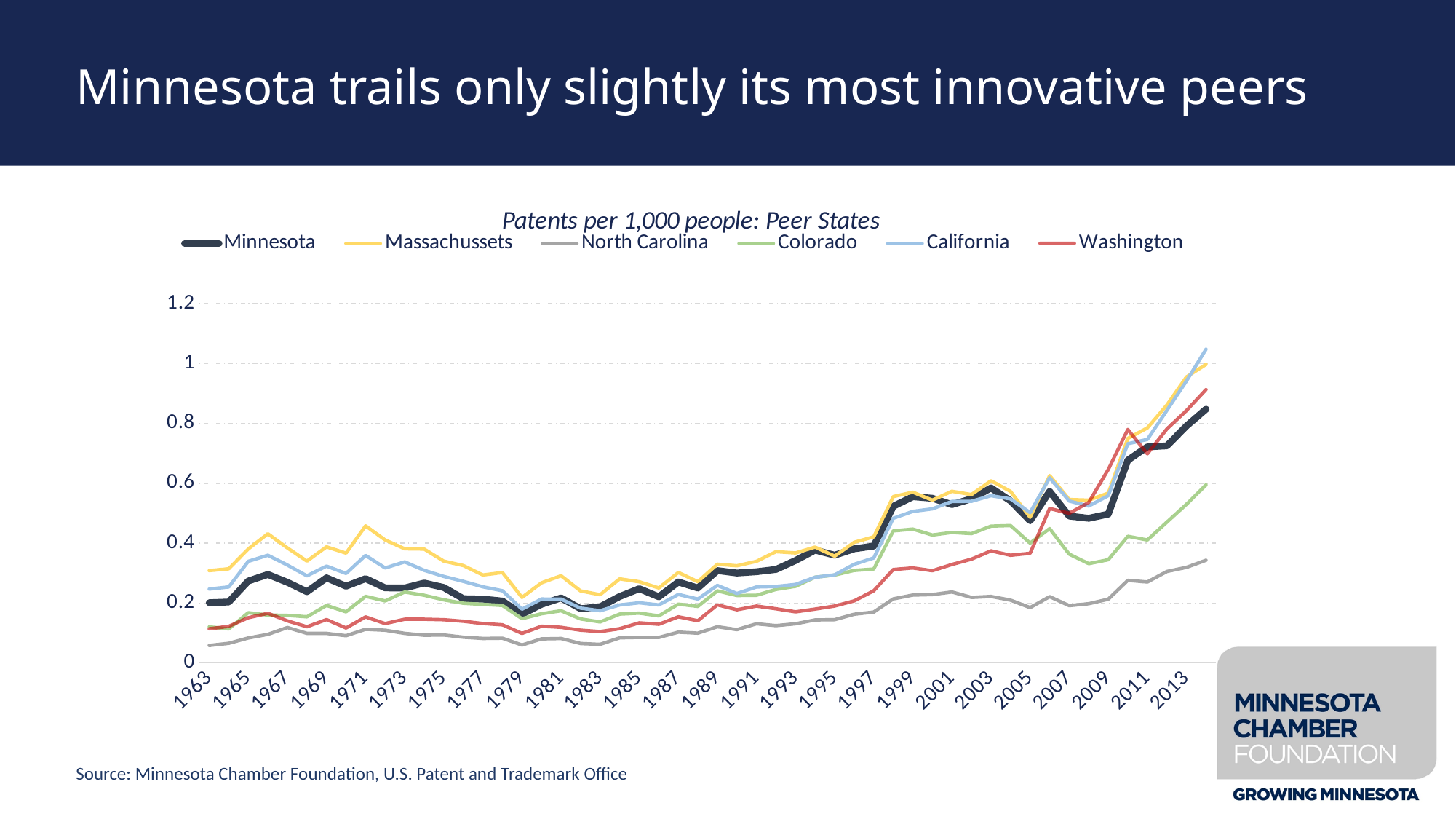
Is the value for Washington at the right end of the chart greater or less than 0.8? greater Does the Minnesota line generally rise or fall from 1963 to the end of the chart? rise What is the title of the chart? Patents per 1,000 people: Peer States At the right end of the chart, which is higher: Washington or Colorado? Washington Which state has the highest value at the right end of the chart (the most recent year)? California Which series is drawn with the thick dark line? Minnesota What kind of chart is shown on the slide? line chart Is the value for California at the right end of the chart greater or less than 1? greater Is the value for North Carolina at the right end of the chart greater or less than 0.4? less How many series does the legend list? 6 Which state has the lowest value at the right end of the chart (the most recent year)? North Carolina